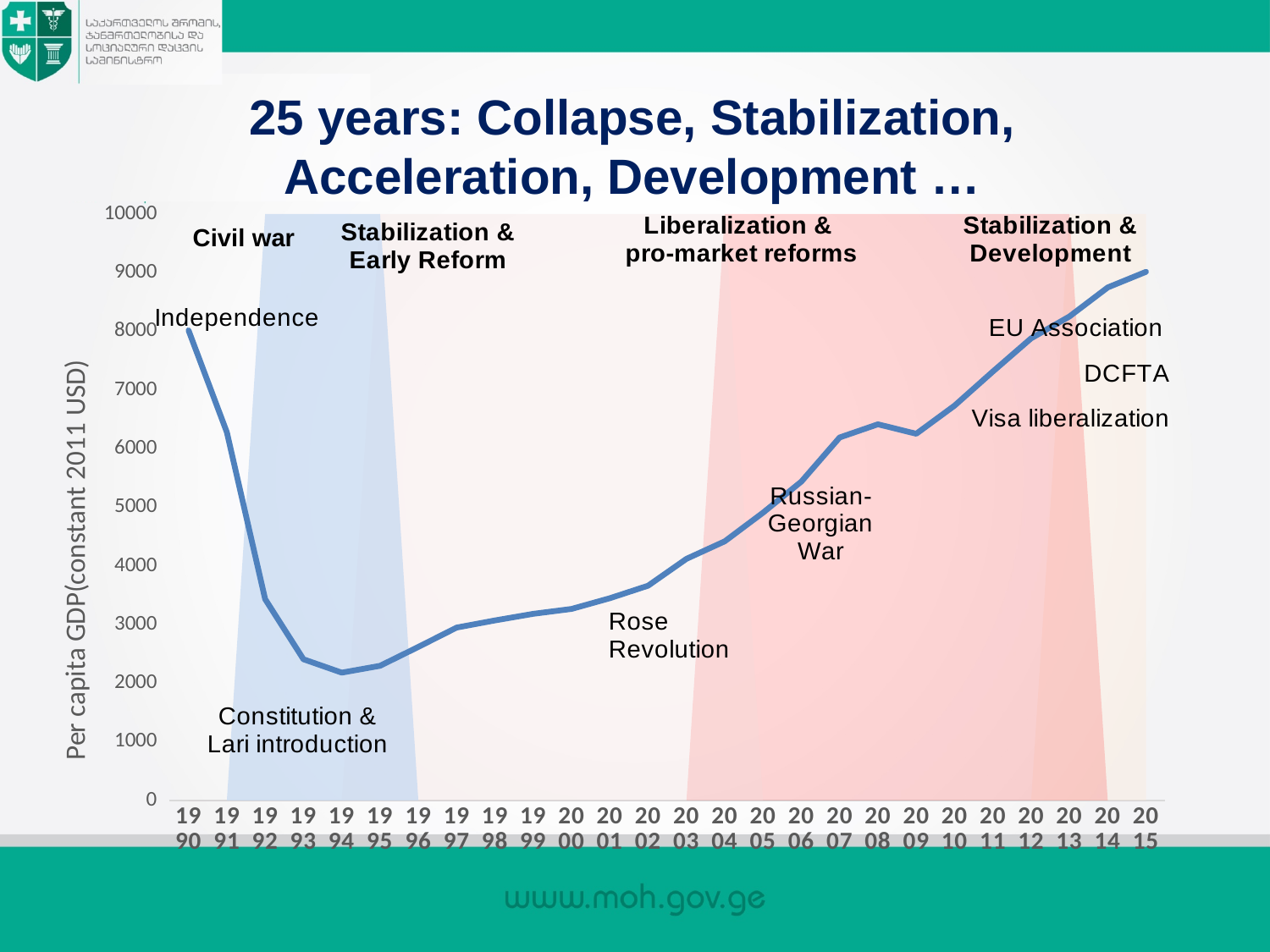
In which year is per capita GDP at its lowest on the chart? 1994 How many years are plotted along the x axis of the chart? 26 In which year is per capita GDP at its highest on the chart? 2015 What is the title of the slide containing the chart? 25 years: Collapse, Stabilization, Acceleration, Development … What kind of chart is shown on the slide? line chart Which year has the higher per capita GDP, 1990 or 2015? 2015 Does per capita GDP rise or fall between 1990 and 1994? fall What is the label of the vertical axis of the chart? Per capita GDP(constant 2011 USD) Is the value for 2008 greater or less than 6000? greater Is the value for 1994 greater or less than 3000? less Is the value for 2003 greater or less than 3000? greater